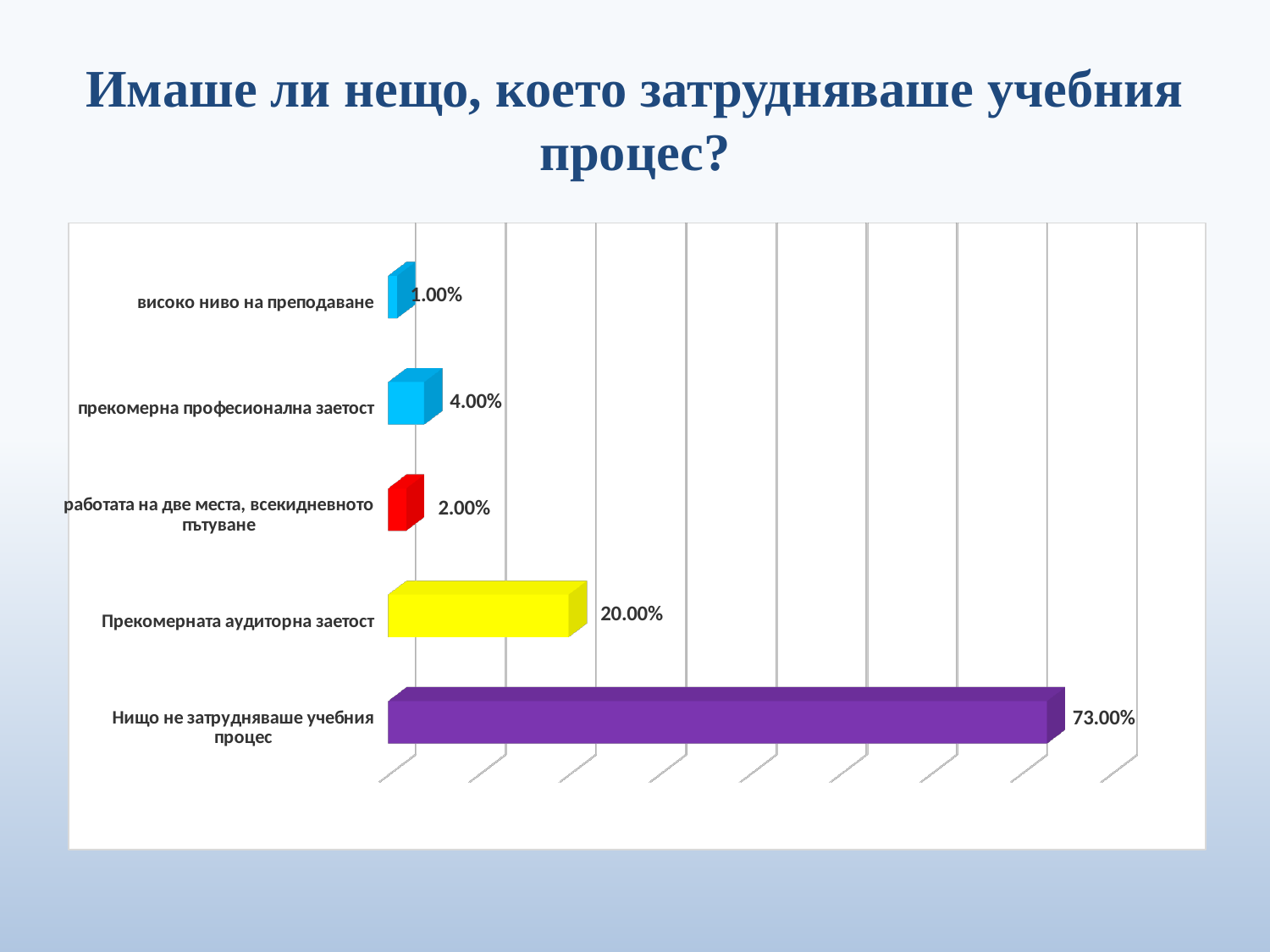
What is the value for "високо ниво на преподаване"? 1.00% Which is larger: the value for "прекомерна професионална заетост" or the value for "работата на две места, всекидневното пътуване"? прекомерна професионална заетост What is the value for "Нищо не затрудняваше учебния процес"? 73.00% What is the value for "прекомерна професионална заетост"? 4.00% What is the value for "Прекомерната аудиторна заетост"? 20.00% What is the value for "работата на две места, всекидневното пътуване"? 2.00% How many categories are shown in the chart? 5 What kind of chart is shown on the slide? Bar chart Which category has the highest value? Нищо не затрудняваше учебния процес Which category has the lowest value? високо ниво на преподаване What colour is the bar for "Прекомерната аудиторна заетост"? Yellow What is the difference between the values for "Нищо не затрудняваше учебния процес" and "Прекомерната аудиторна заетост"? 53.00%